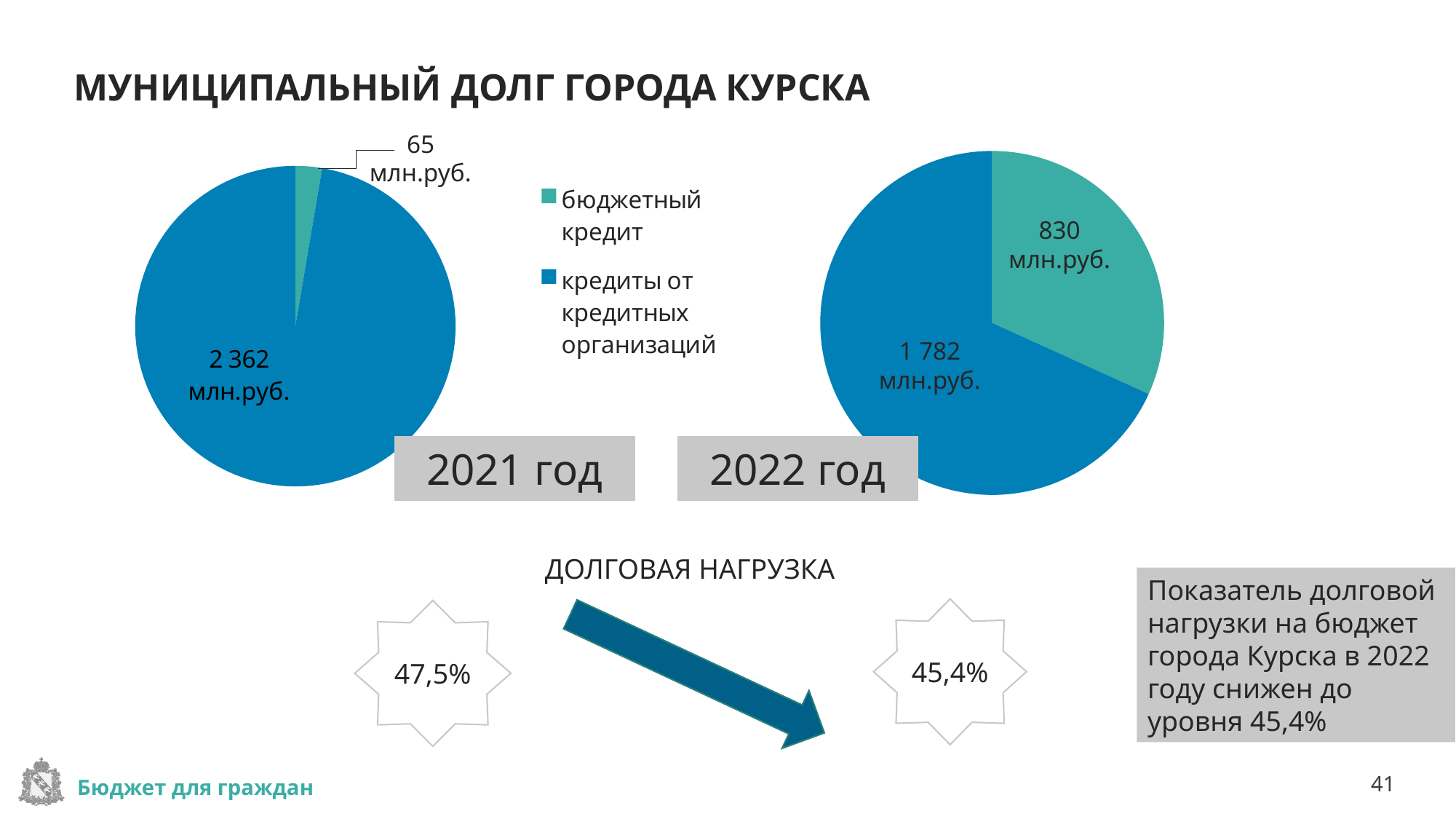
What colour represents бюджетный кредит in the pie charts? teal (green) On the 2021 год pie chart, what is the value for бюджетный кредит? 65 млн.руб. Comparing the two pie charts, is кредиты от кредитных организаций larger in 2021 год or in 2022 год? 2021 год Comparing the two pie charts, by how much did бюджетный кредит increase from 2021 год to 2022 год? 765 млн.руб. On the 2021 год pie chart, which category is the largest? кредиты от кредитных организаций On the 2022 год pie chart, what is the value for бюджетный кредит? 830 млн.руб. How many categories does the legend list for the pie charts? 2 On the 2021 год pie chart, what is the value for кредиты от кредитных организаций? 2 362 млн.руб. On the 2022 год pie chart, what is the value for кредиты от кредитных организаций? 1 782 млн.руб. On the 2022 год pie chart, which category is the smallest? бюджетный кредит On the 2022 год pie chart, what is the difference between кредиты от кредитных организаций and бюджетный кредит? 952 млн.руб. What type of chart is used to show the municipal debt for 2021 год and 2022 год? pie chart